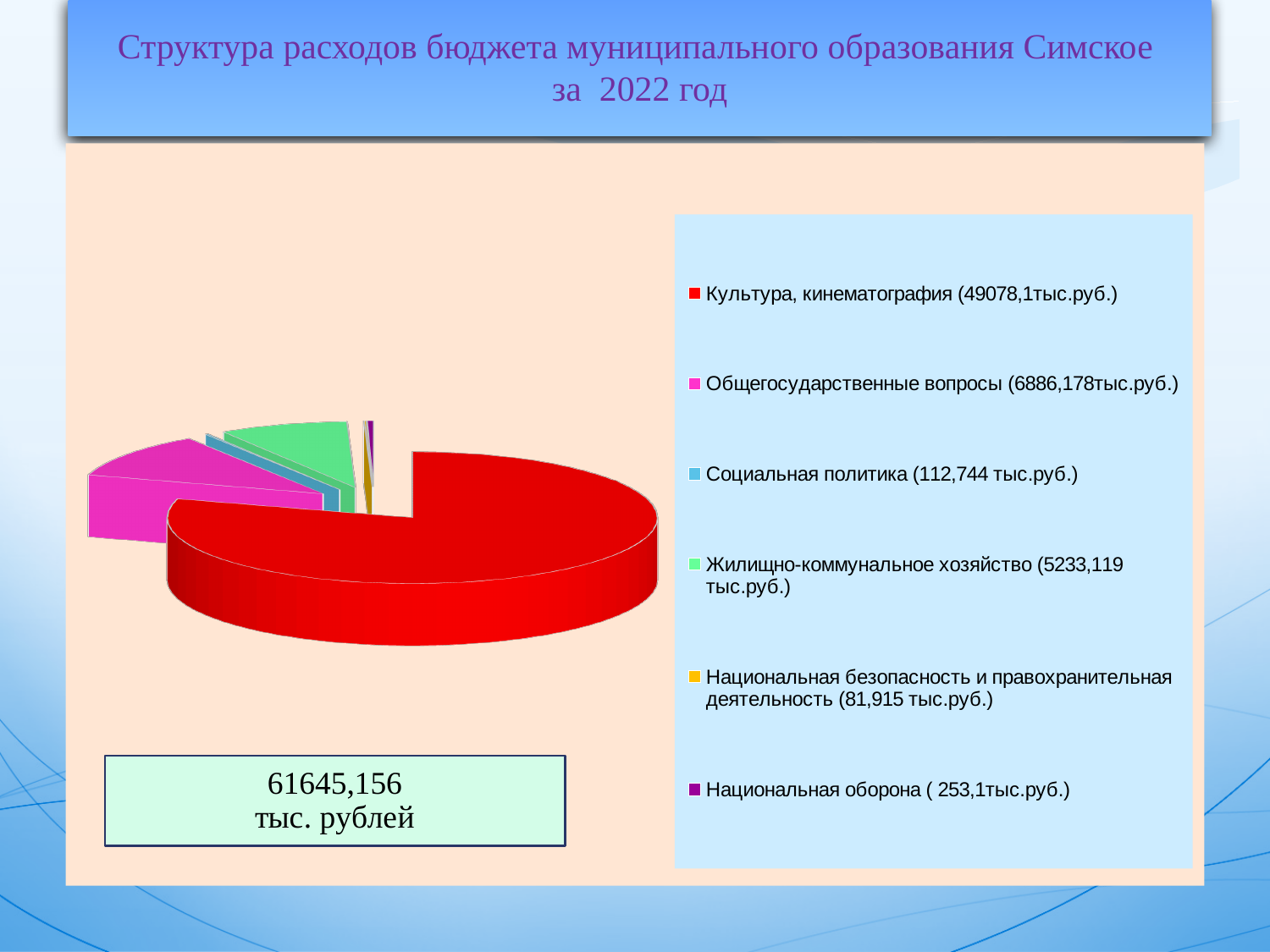
What is the value for Жилищно-коммунальное хозяйство? 5233,119 тыс.руб. How many categories does the pie chart's legend list? 6 What kind of chart is shown on the slide? pie chart Which category has the largest share of the pie? Культура, кинематография What is the value for Социальная политика? 112,744 тыс.руб. What total amount is shown in the box below the pie chart? 61645,156 тыс. рублей What is the difference between Общегосударственные вопросы and Жилищно-коммунальное хозяйство? 1653,059 тыс.руб. Which category has the smallest value? Национальная безопасность и правохранительная деятельность What is the value for Культура, кинематография? 49078,1 тыс.руб. Which is larger: Общегосударственные вопросы or Жилищно-коммунальное хозяйство? Общегосударственные вопросы What is the value for Общегосударственные вопросы? 6886,178 тыс.руб. What is the value for Национальная оборона? 253,1 тыс.руб.